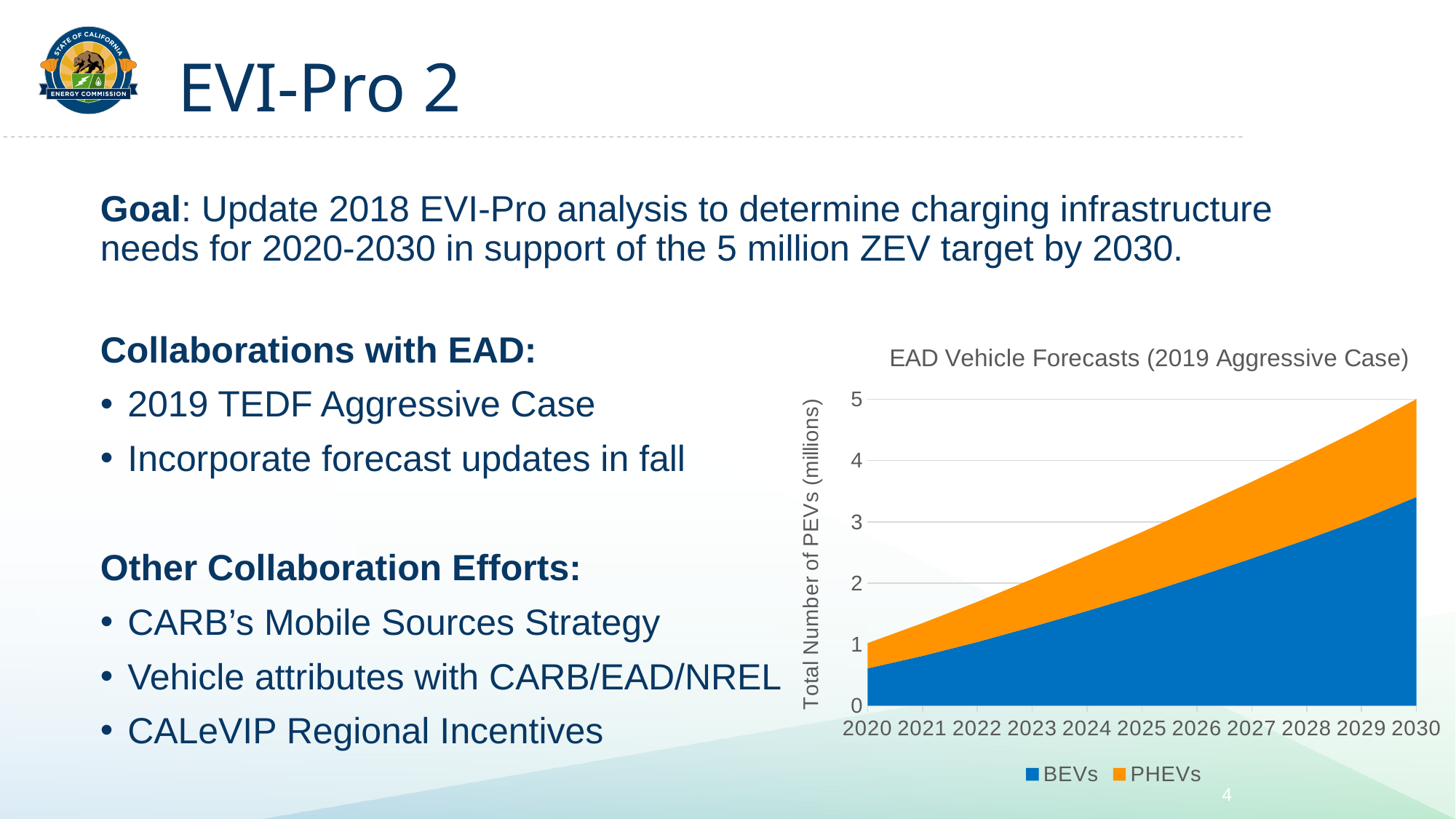
Is the total number of PEVs in 2030 greater or less than 4 million? greater In which year is the total number of PEVs highest? 2030 How many years are shown along the x axis of the chart? 11 How many series does the chart's legend list? 2 In 2030, which series is larger, BEVs or PHEVs? BEVs Is the number of BEVs in 2030 greater or less than 3 million? greater Is the total number of PEVs in 2020 greater or less than 2 million? less Which two series are listed in the chart's legend? BEVs and PHEVs Does the total number of PEVs rise or fall from 2020 to 2030? Rise What kind of chart is shown on the slide? Stacked area chart What is the title of the chart? EAD Vehicle Forecasts (2019 Aggressive Case)